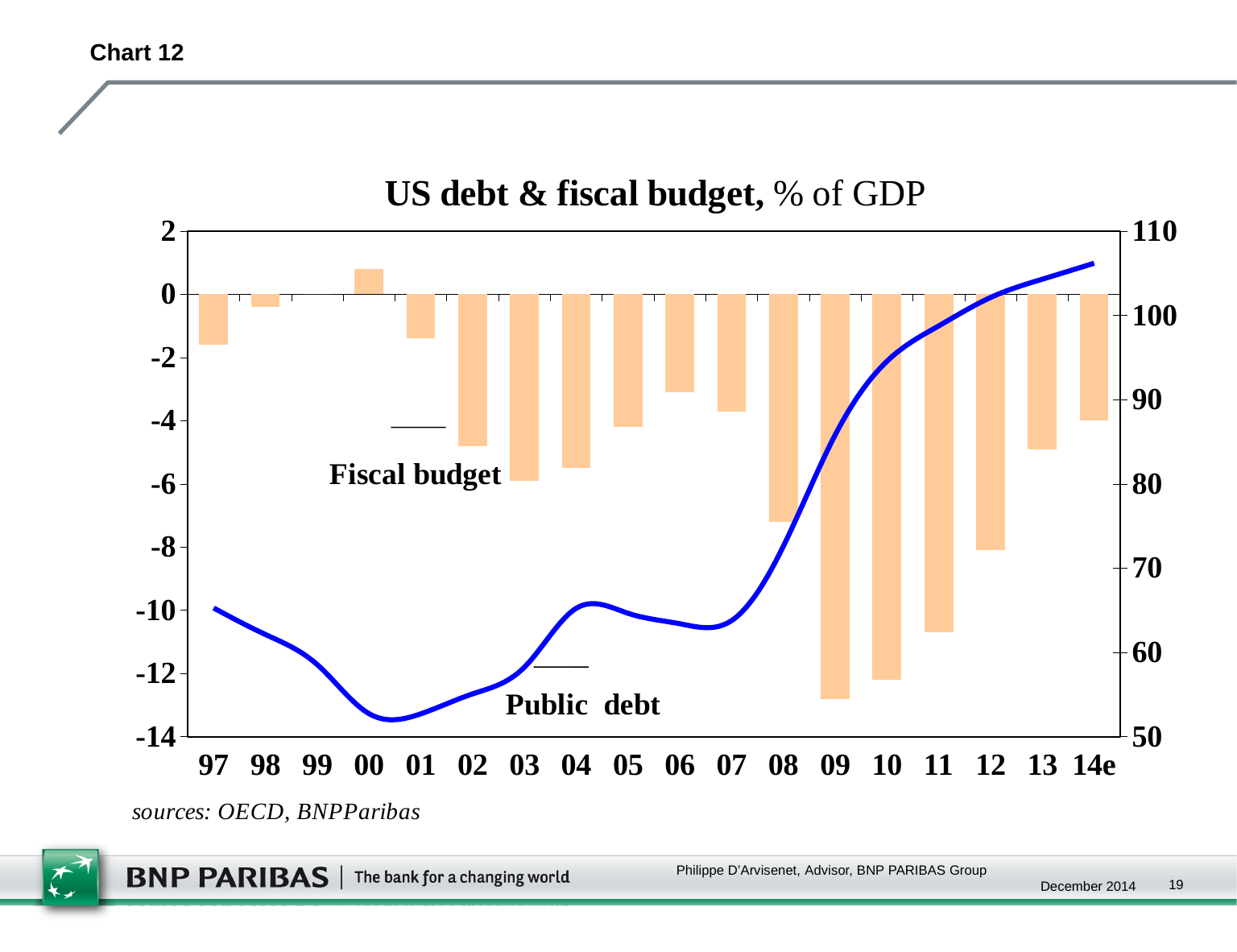
Which year has the larger fiscal budget value, 03 or 05? 05 How many years are shown on the x axis? 18 In which year is the fiscal budget bar the lowest (most negative)? 09 Is the fiscal budget value for 08 greater or less than -6? less What is the title of the chart? US debt & fiscal budget, % of GDP In which year is the fiscal budget bar the highest (the only positive bar)? 00 What kind of chart is shown on the slide? A combined bar and line chart Is the public debt value for 14e greater or less than 100? greater Which series is drawn as the blue line? Public debt Does the public debt line rise or fall from 08 to 14e? rises Is the public debt value for 97 greater or less than 70? less